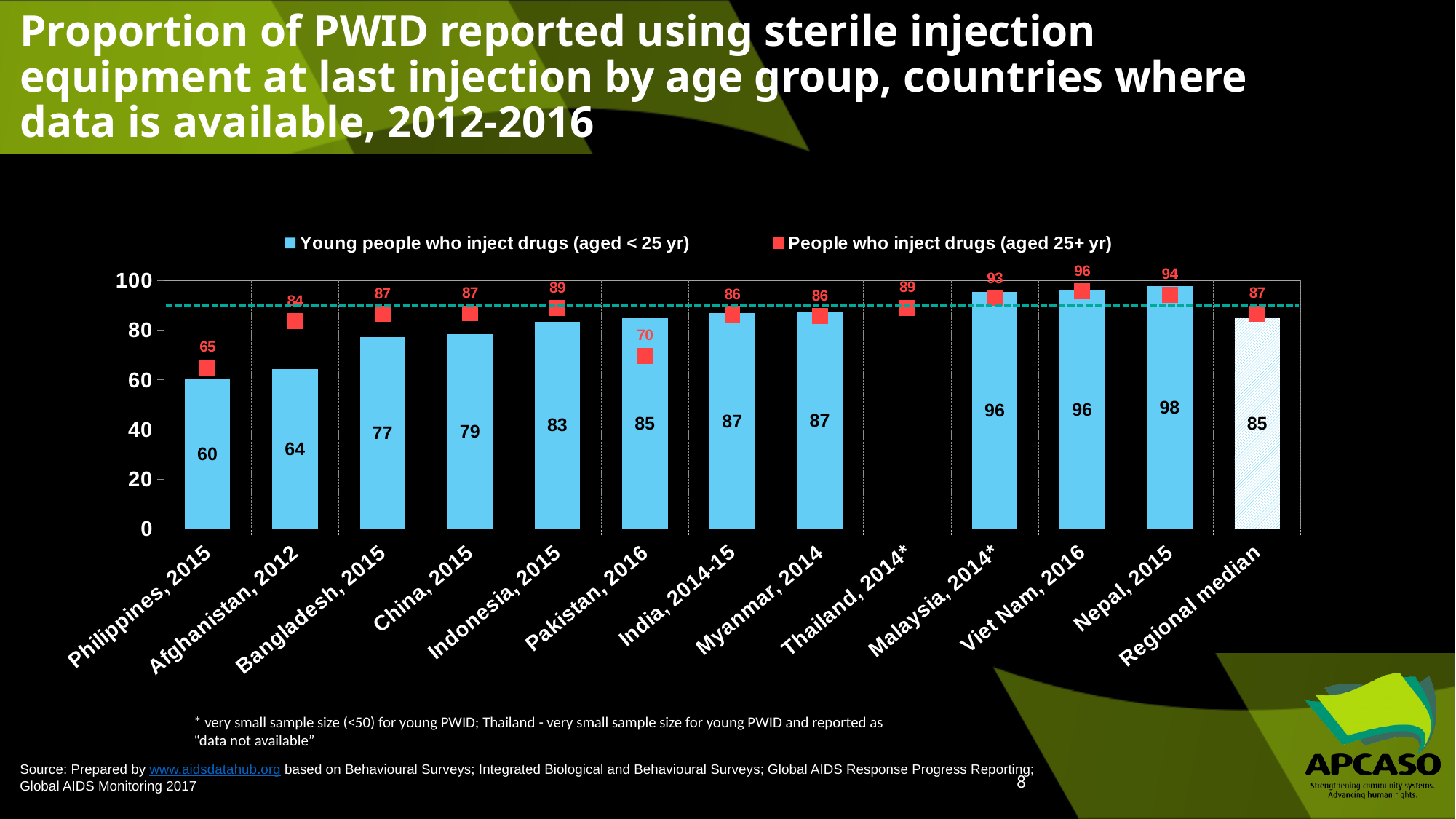
What is the difference between the young people (aged < 25 yr) values for Nepal, 2015 and Philippines, 2015? 38 How many categories are shown on the x axis of the chart? 13 Which country has the highest value for young people who inject drugs (aged < 25 yr)? Nepal, 2015 What is the regional median value for young people who inject drugs (aged < 25 yr)? 85 What is the value for young people who inject drugs (aged < 25 yr) in Philippines, 2015? 60 In Afghanistan, 2012, which is larger: the value for young people who inject drugs (aged < 25 yr) or the value for people who inject drugs (aged 25+ yr)? People who inject drugs (aged 25+ yr) Which country has the highest value for people who inject drugs (aged 25+ yr)? Viet Nam, 2016 How many series does the chart legend list? 2 What kind of chart is shown on the slide? Combination chart: bars for the under-25 series with square markers (line series) for the 25+ series What is the value for people who inject drugs (aged 25+ yr) in Pakistan, 2016? 70 Which country has the lowest value for young people who inject drugs (aged < 25 yr)? Philippines, 2015 In Pakistan, 2016, what is the difference between the value for young people who inject drugs (aged < 25 yr) and the value for people who inject drugs (aged 25+ yr)? 15